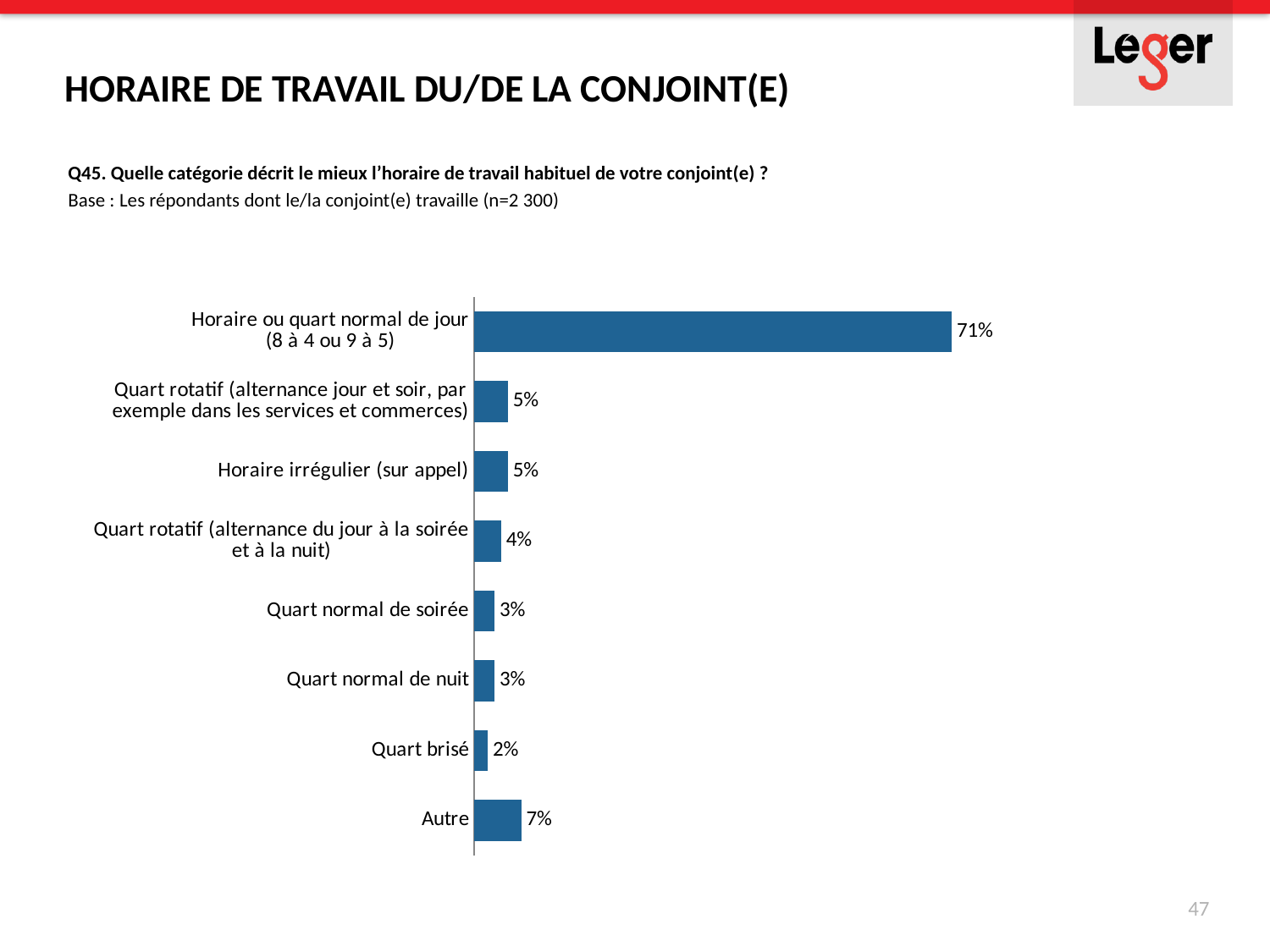
What kind of chart is shown on the slide? Bar chart What is the value for "Quart brisé"? 2% How many categories are shown in the chart? 8 What is the value for "Autre"? 7% What is the difference between the values for "Quart normal de soirée" and "Quart brisé"? 1% What is the value for "Horaire irrégulier (sur appel)"? 5% Which category has the lowest value? Quart brisé Which is larger, the value for "Autre" or the value for "Quart rotatif (alternance du jour à la soirée et à la nuit)"? Autre What is the value for "Quart normal de nuit"? 3% Which category has the highest value? Horaire ou quart normal de jour (8 à 4 ou 9 à 5) What is the difference between the values for "Horaire ou quart normal de jour (8 à 4 ou 9 à 5)" and "Autre"? 64% What is the value for "Horaire ou quart normal de jour (8 à 4 ou 9 à 5)"? 71%